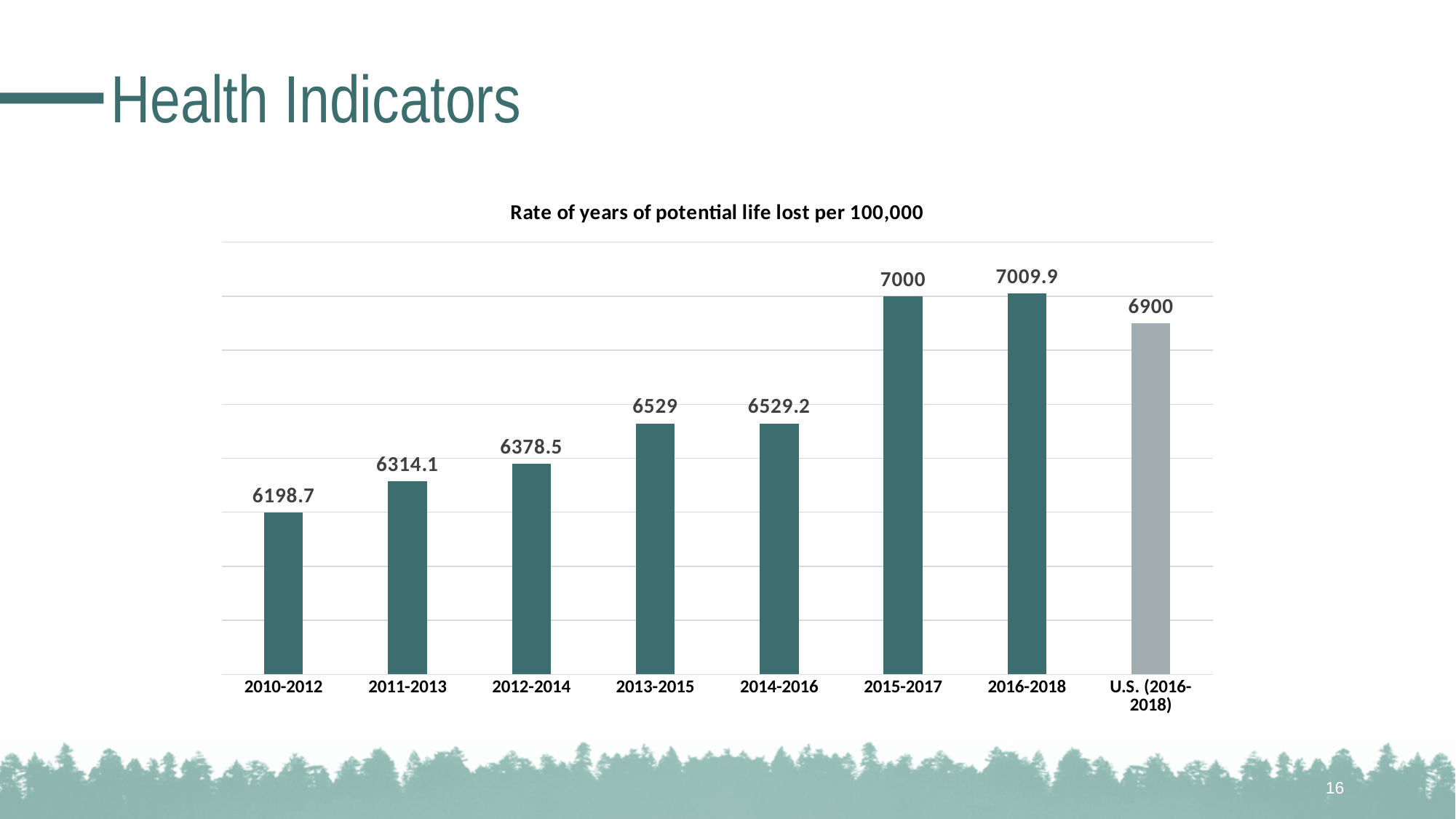
What is the difference between the values for 2016-2018 and U.S. (2016-2018)? 109.9 Do the values for the local periods from 2010-2012 to 2016-2018 generally rise or fall? rise What kind of chart is shown on the slide? bar chart What is the value shown for U.S. (2016-2018)? 6900 What is the value shown for 2016-2018? 7009.9 How many bars are shown in the chart? 8 Which is larger, the value for 2012-2014 or the value for 2013-2015? 2013-2015 What is the title of the chart? Rate of years of potential life lost per 100,000 What is the rate of years of potential life lost per 100,000 for 2010-2012? 6198.7 Which category has the lowest value? 2010-2012 Which category has the highest value? 2016-2018 What is the difference between the values for 2015-2017 and 2014-2016? 470.8